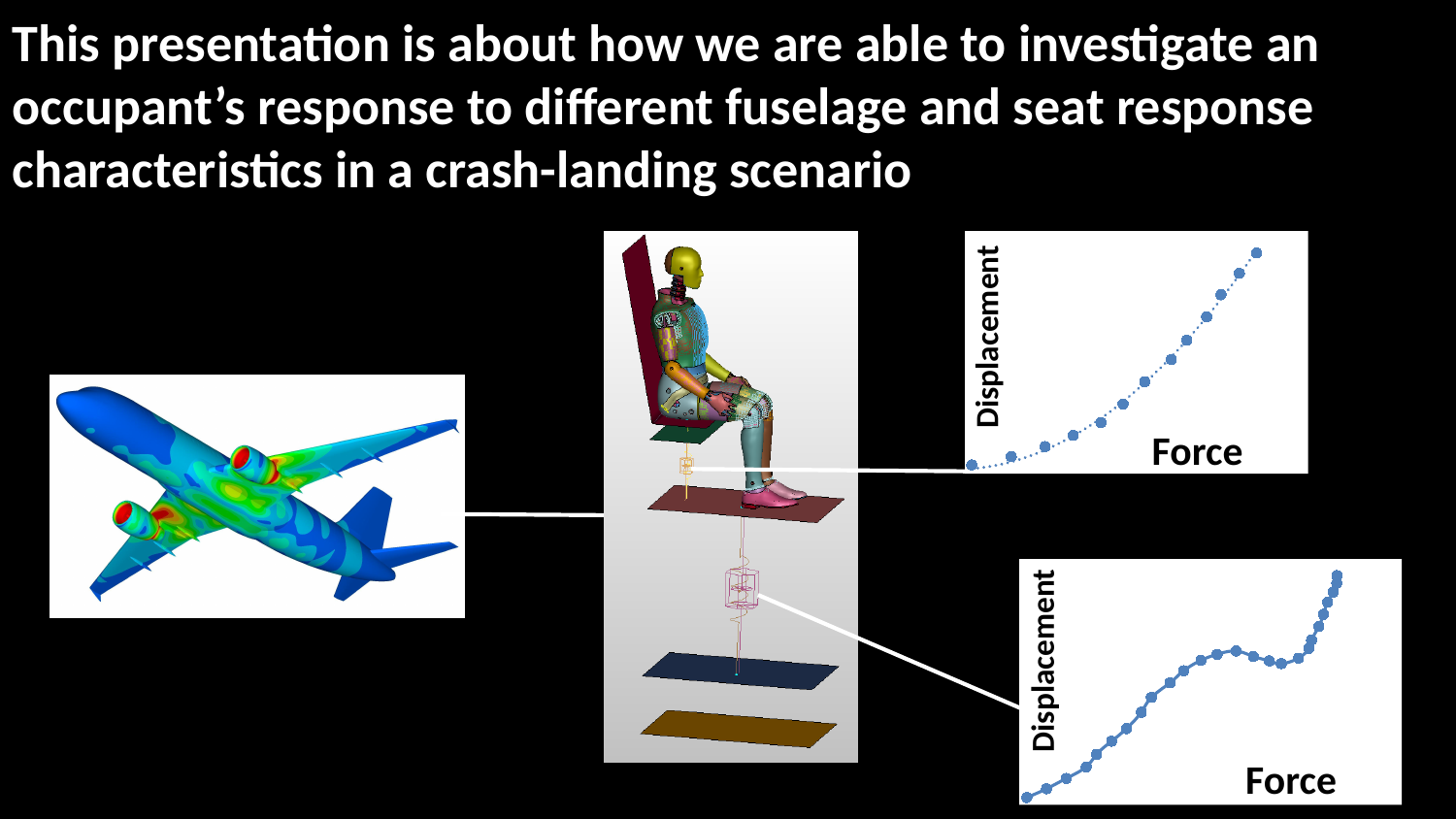
Is the lower-right chart a bar chart, a pie chart, or a chart of points connected by a line? points connected by a line Which chart has more plotted points, the upper-right chart or the lower-right chart? lower-right chart Is the upper-right chart a bar chart, a pie chart, or a chart of points connected by a line? points connected by a line In the lower-right chart, does Displacement overall rise or fall from the left end to the right end of the x axis? rise In the upper-right chart, what is the label on the vertical axis? Displacement In the upper-right chart, does Displacement rise or fall as Force increases along the x axis? rise In the upper-right chart, is the curve steeper at the left end or at the right end of the Force axis? right end How many charts are shown on the slide? 2 In the lower-right chart, what is the label on the horizontal axis? Force